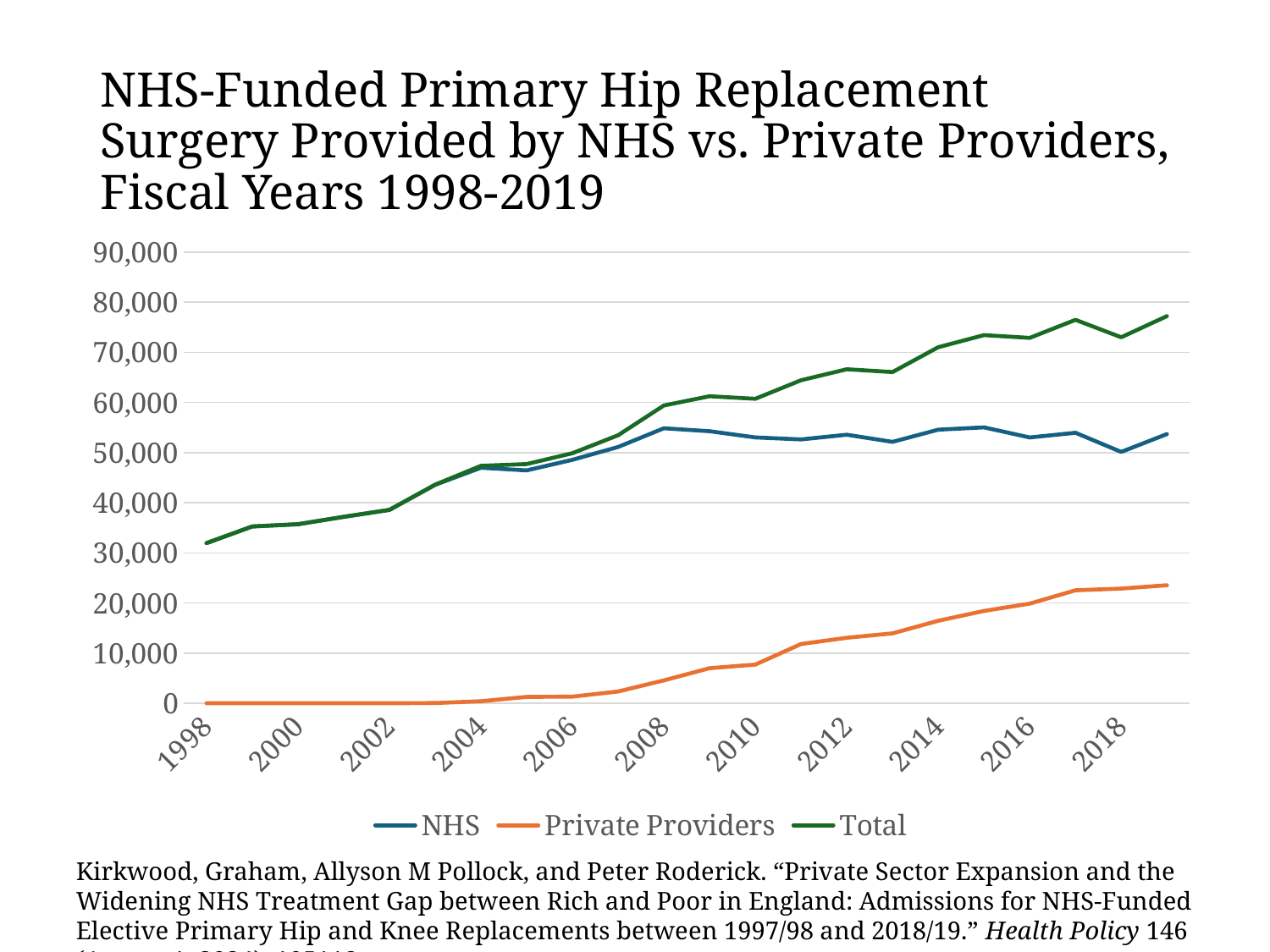
Is the Private Providers value for 2010 greater or less than 10,000? less Is the Total value for 1998 greater or less than 40,000? less Which series is drawn in orange? Private Providers Does the Private Providers line rise or fall from 1998 to 2019? rise How many series does the legend list? 3 In 2019, which is larger, the NHS value or the Private Providers value? NHS Which series has the lowest values throughout the period shown? Private Providers Is the Total value for 2018 greater or less than 70,000? greater What are the three series named in the legend? NHS, Private Providers, Total What kind of chart is shown on the slide? line chart Does the Total line generally rise or fall across the fiscal years shown? rise